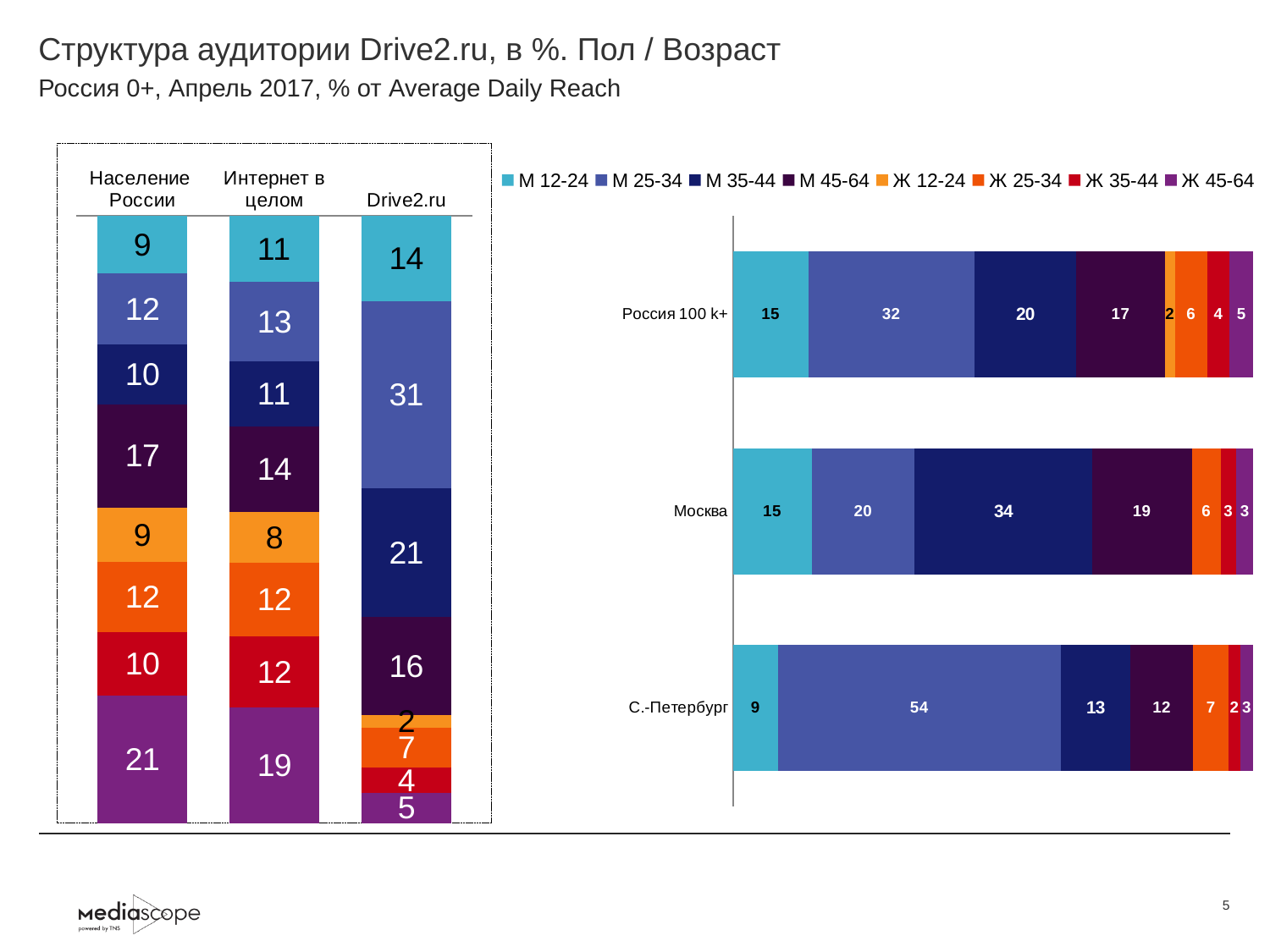
In the left chart, which column has the lowest value for Ж 12-24? Drive2.ru What kind of chart is the right chart? Stacked bar chart In the left chart, what is the difference between the М 25-34 values for Drive2.ru and Интернет в целом? 18 In the left chart, what is the value for М 25-34 in the Drive2.ru column? 31 In the right chart, what is the value for М 25-34 in С.-Петербург? 54 How many categories are shown in the right chart? 3 In the right chart, which category has the highest value for М 25-34? С.-Петербург In the right chart, what is the total of the М 12-24 and М 25-34 segments for Россия 100 k+? 47 In the left chart, what is the value for Ж 45-64 in the Население России column? 21 In the right chart, which is larger: М 45-64 in Москва or М 45-64 in Россия 100 k+? Москва In the right chart, what is the value for М 35-44 in Москва? 34 How many series does the legend on the right list? 8